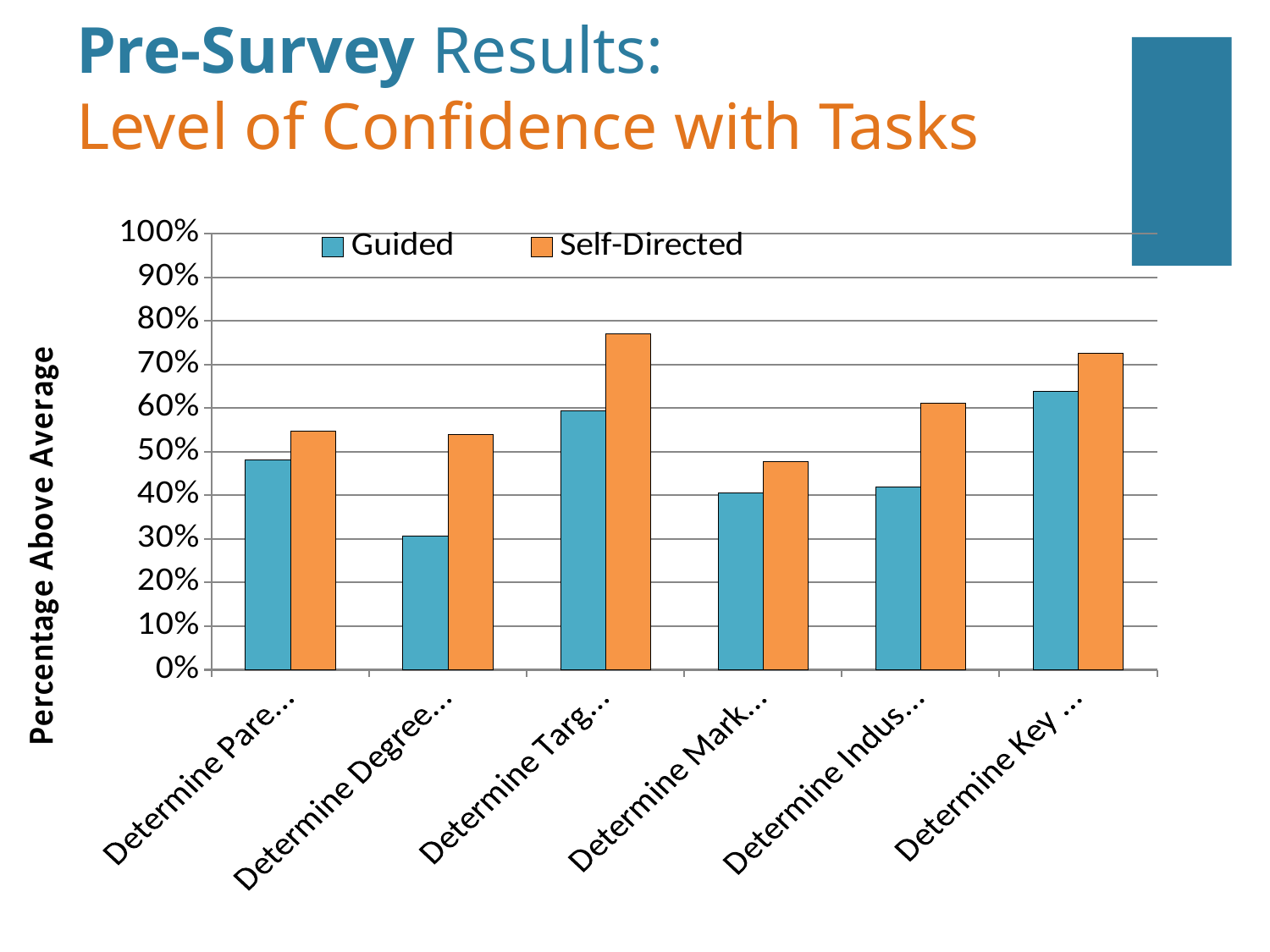
For the fifth category (Determine Indus...), which series has the larger value, Guided or Self-Directed? Self-Directed Is the Guided value for the second category (Determine Degree...) greater or less than 40%? less What kind of chart is shown on the slide? bar chart Which category has the lowest Guided value? Determine Degree... How many series does the legend list? 2 What is the title of the vertical axis? Percentage Above Average Is the Guided value for the first category (Determine Pare...) greater or less than 60%? less How many task categories are plotted along the x axis? 6 What are the two series named in the legend? Guided and Self-Directed Is the Self-Directed value for the third category (Determine Targ...) greater or less than 70%? greater Which category has the highest Guided value? Determine Key ... Which category has the highest Self-Directed value? Determine Targ...